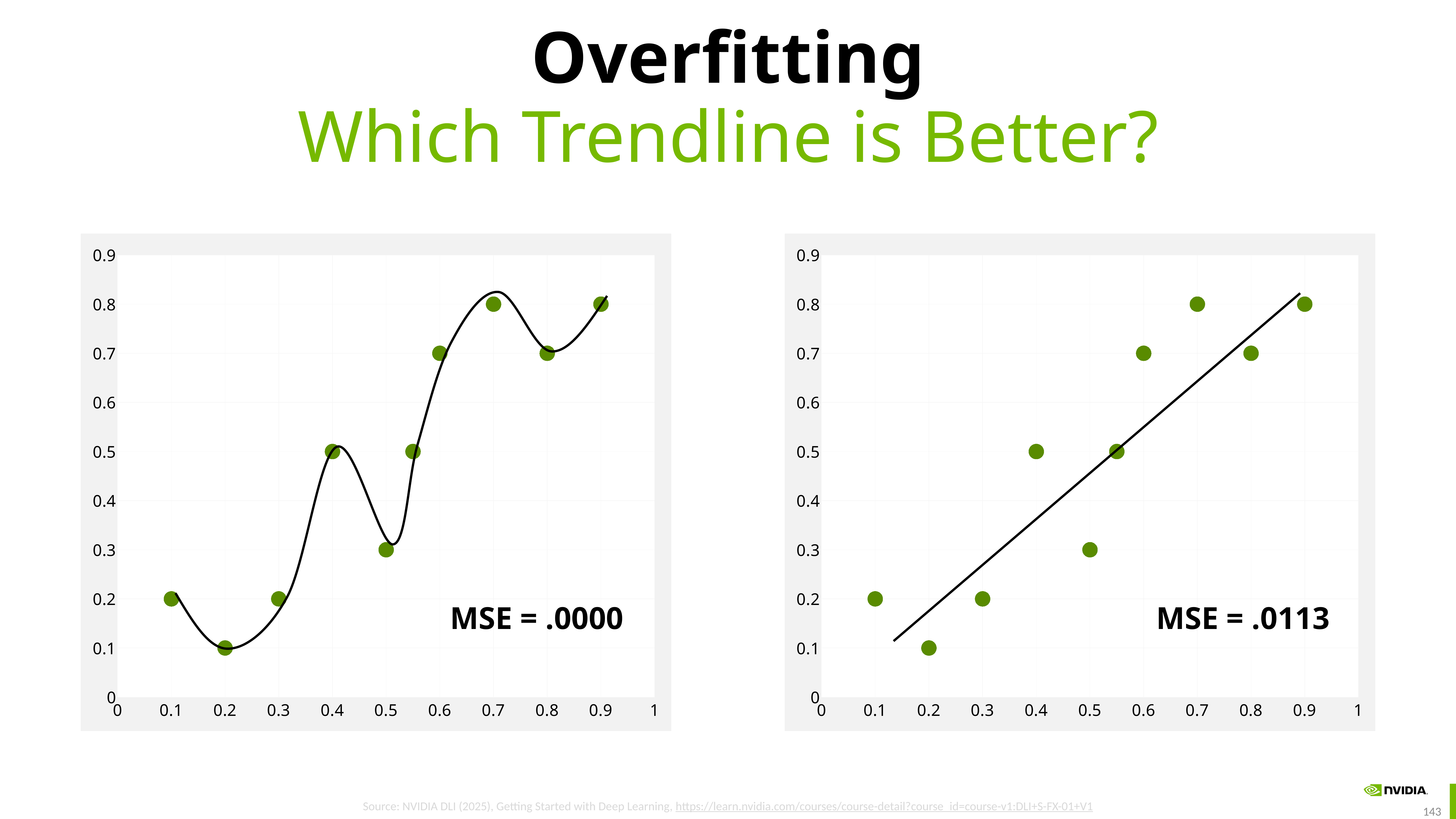
On the right chart, do the points generally rise or fall as x increases? rise On the right chart, which point has the larger y value: the one at x = 0.4 or the one at x = 0.5? x = 0.4 On the left chart, what is the difference between the y values of the points at x = 0.7 and x = 0.1? 0.6 On the right chart, at which x value is the lowest point plotted? 0.2 On the left chart, what is the y value of the point at x = 0.4? 0.5 On the left chart, what is the highest y value reached by any point? 0.8 On the left chart, what is the y value of the point at x = 0.2? 0.1 How many data points are plotted on the left chart? 10 On the right chart, what is the y value of the point at x = 0.7? 0.8 How many data points are plotted on the right chart? 10 What MSE value is shown on the right chart? MSE = .0113 What kind of chart is the left chart? scatter chart